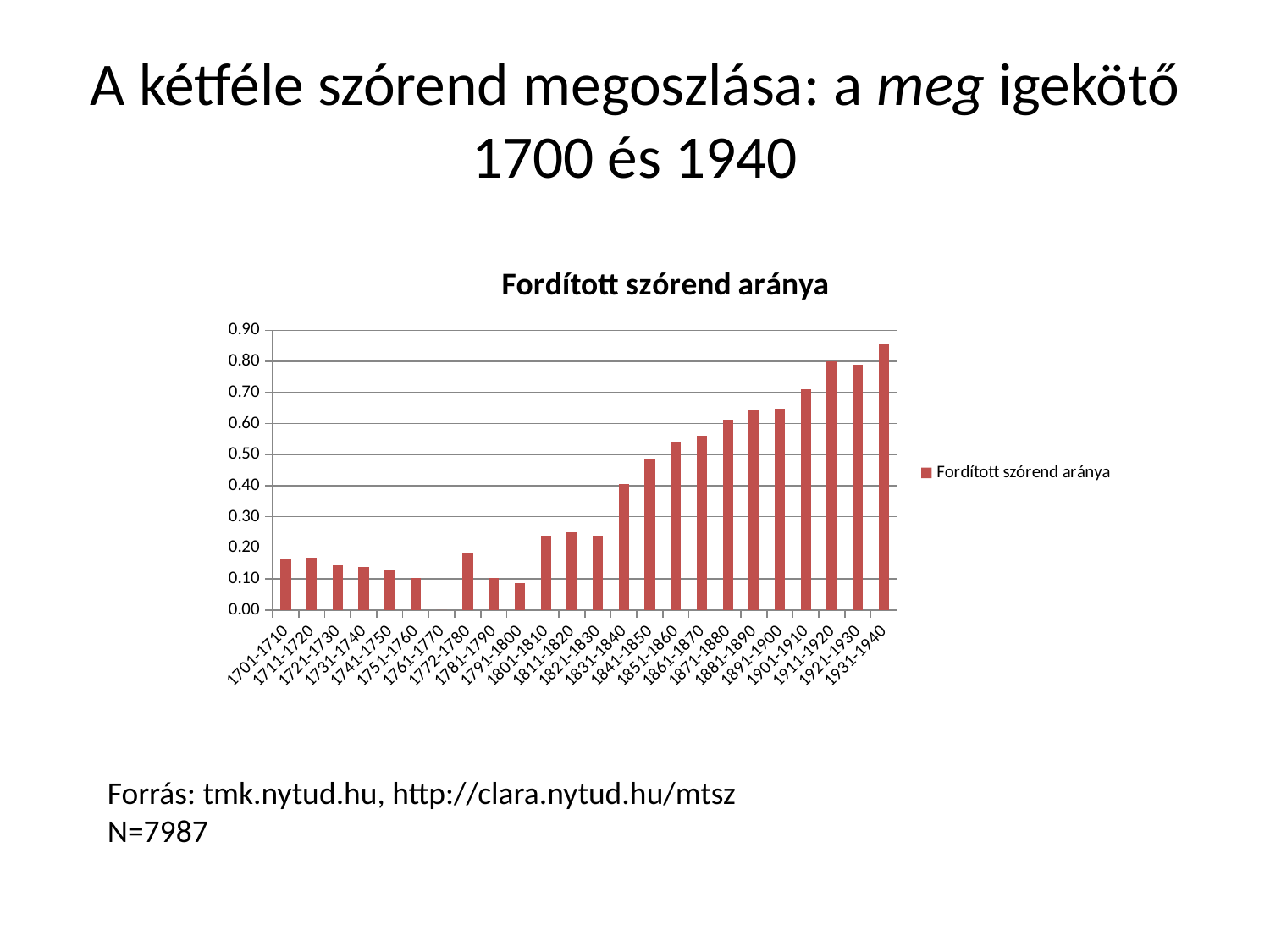
Is the value for 1891-1900 greater or less than 0.60? greater What kind of chart is shown on the slide? bar chart How many decade categories are shown on the x axis? 24 Which is larger, the value for 1851-1860 or the value for 1811-1820? 1851-1860 What is the title of the chart? Fordított szórend aránya Which is larger, the value for 1701-1710 or the value for 1931-1940? 1931-1940 Which decade has the highest value? 1931-1940 Is the value for 1841-1850 greater or less than 0.50? less How many series does the legend list? 1 Is the value for 1811-1820 greater or less than 0.30? less Do the values generally rise or fall from 1701-1710 to 1931-1940? rise